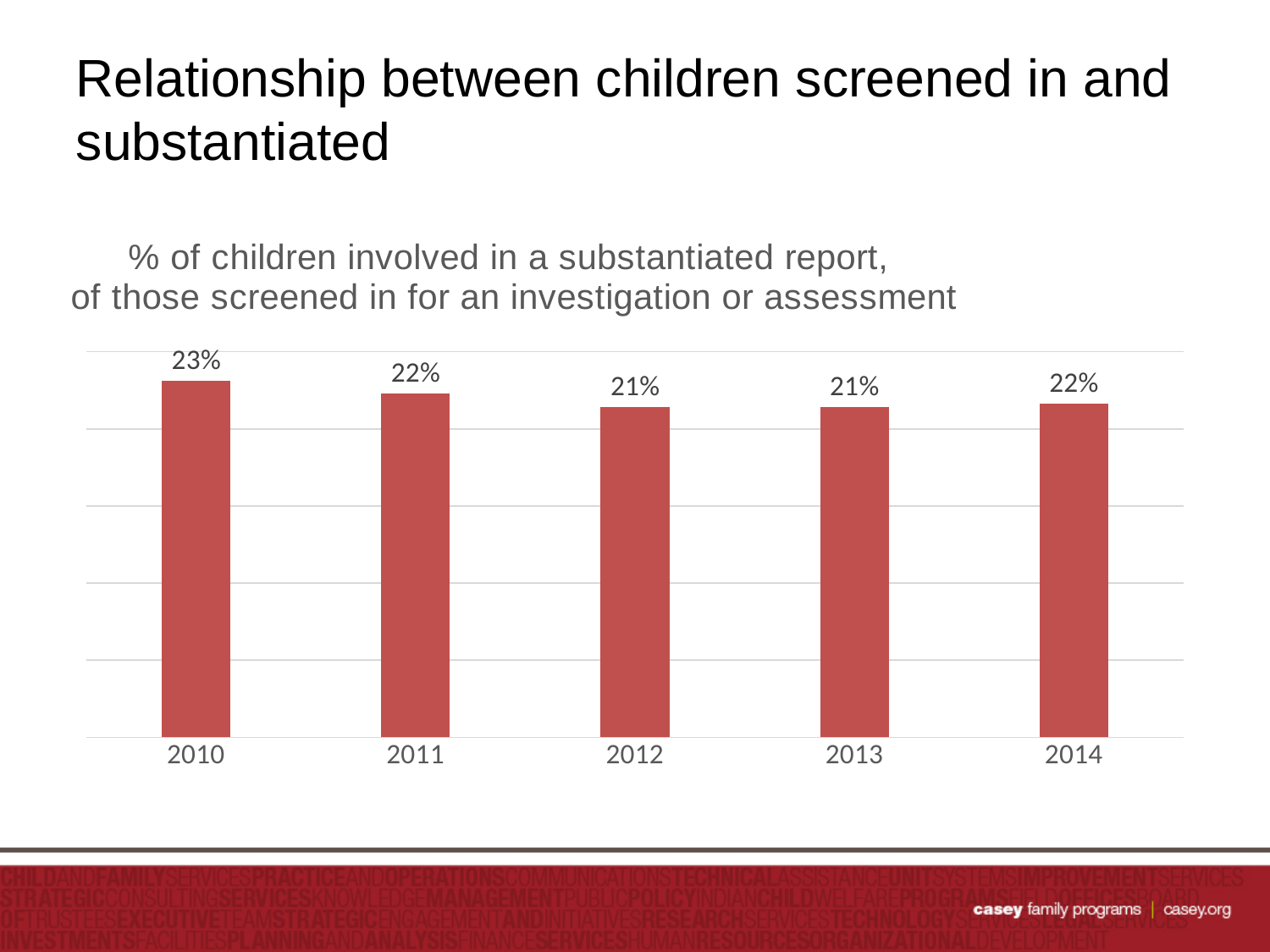
What is the difference between the values for 2010 and 2012? 2% What is the value for 2014? 22% Does the value rise or fall from 2010 to 2012? fall Which year has the highest value? 2010 What is the value for 2012? 21% What is the difference between the values for 2011 and 2014? 0% Which is larger, the value for 2010 or the value for 2013? 2010 What is the value for 2010? 23% What colour are the bars? red How many years are shown on the x axis? 5 What kind of chart is this? bar chart What is the value for 2013? 21%